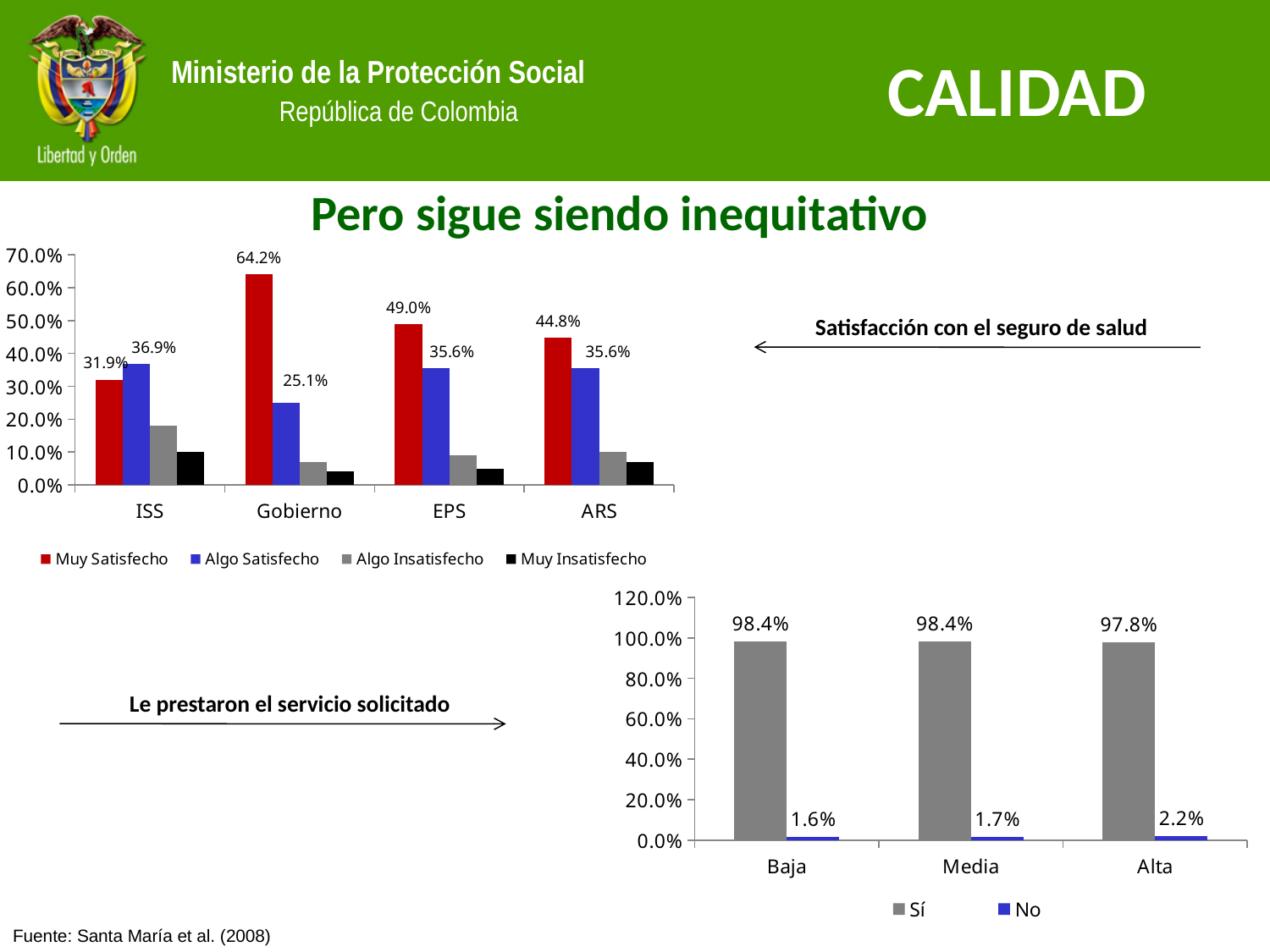
In the top-left chart (Satisfacción con el seguro de salud), what is the Algo Satisfecho value for ISS? 36.9% In the top-left chart (Satisfacción con el seguro de salud), which category has the highest Muy Satisfecho value? Gobierno In the top-left chart (Satisfacción con el seguro de salud), is the Algo Insatisfecho value for ISS greater or less than 10.0%? greater In the top-left chart (Satisfacción con el seguro de salud), what is the Muy Satisfecho value for Gobierno? 64.2% In the bottom-right chart (Le prestaron el servicio solicitado), what is the No value for Media? 1.7% In the bottom-right chart (Le prestaron el servicio solicitado), what is the Sí value for Alta? 97.8% How many categories are shown on the x axis of the bottom-right chart (Le prestaron el servicio solicitado)? 3 In the top-left chart (Satisfacción con el seguro de salud), what is the difference between the Muy Satisfecho values for EPS and ARS? 4.2% In the top-left chart (Satisfacción con el seguro de salud), which category has the lowest Muy Satisfecho value? ISS How many series does the legend of the top-left chart (Satisfacción con el seguro de salud) list? 4 What kind of chart is the bottom-right chart (Le prestaron el servicio solicitado)? Bar chart In the bottom-right chart (Le prestaron el servicio solicitado), which category has the highest No value? Alta